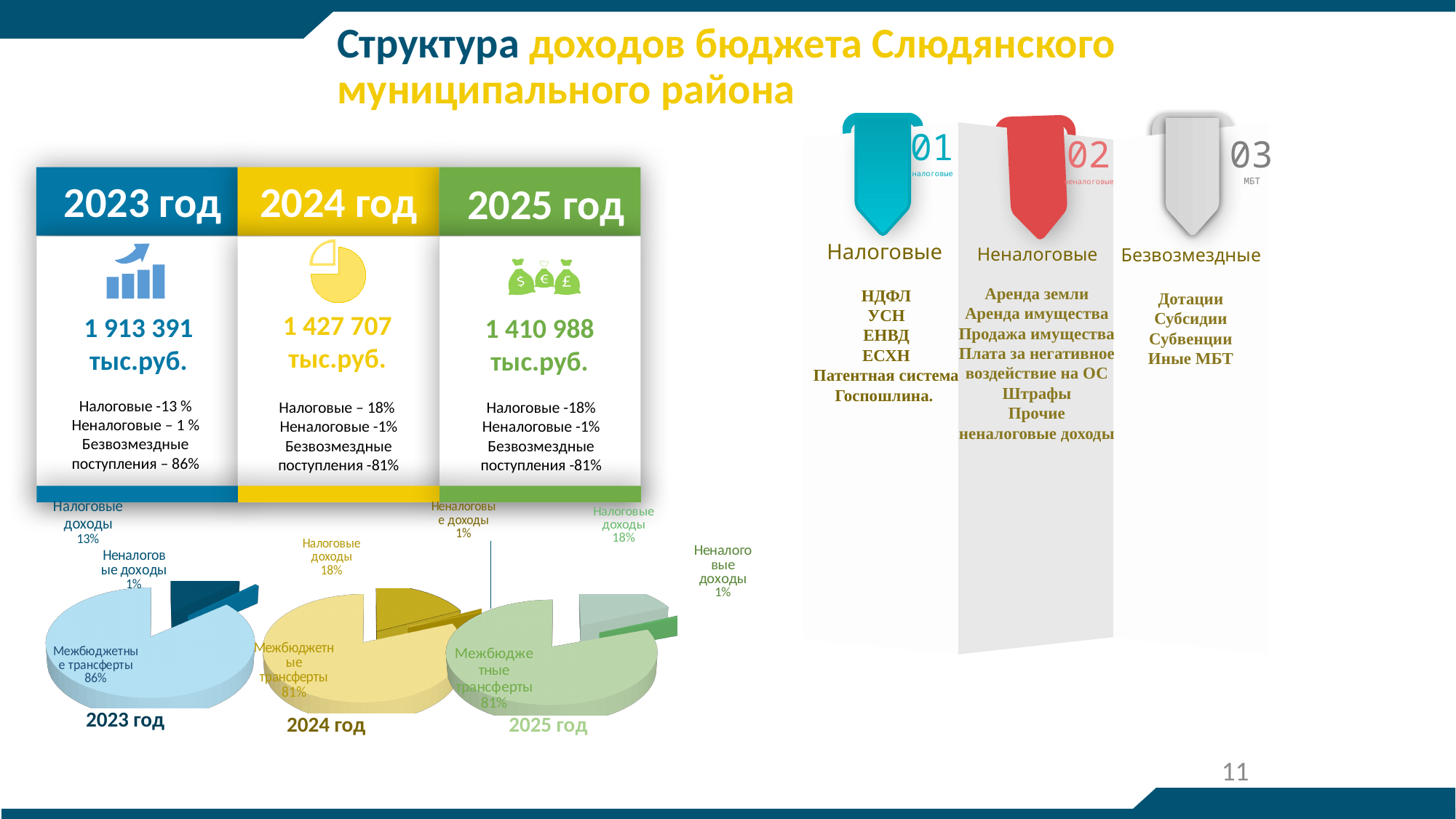
Which is larger: the Налоговые доходы share in the 2023 год pie chart or in the 2024 год pie chart? 2024 год How many pie charts are shown on the slide? 3 In the 2025 год pie chart, what share is labelled for Неналоговые доходы? 1% What type of chart is used for 2025 год? Pie chart In the 2023 год pie chart, what is the difference between the Межбюджетные трансферты share and the Налоговые доходы share? 73% Which year's pie chart is drawn in yellow? 2024 год In the 2023 год pie chart, which slice is the largest? Межбюджетные трансферты In the 2024 год pie chart, what share is labelled for Налоговые доходы? 18% In the 2025 год pie chart, which slice is the smallest? Неналоговые доходы How many slices does the 2023 год pie chart have? 3 In the 2023 год pie chart, what share is labelled for Межбюджетные трансферты? 86% In the 2024 год pie chart, what is the difference between the Межбюджетные трансферты share and the Налоговые доходы share? 63%